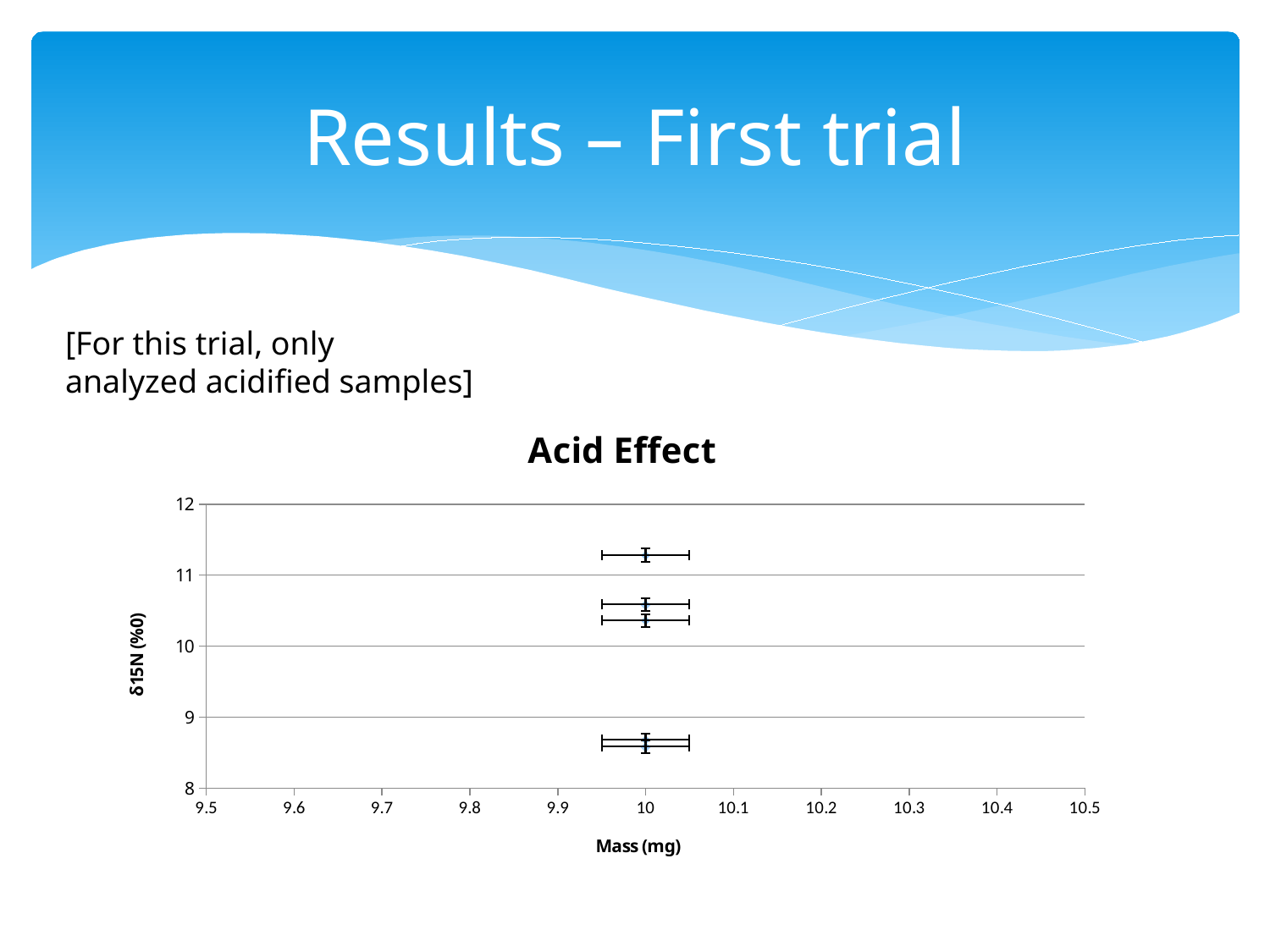
Is the δ15N value of the highest data point greater or less than 12? less What kind of chart is shown on the slide? scatter chart How many data points are plotted on the chart? 5 What is the highest value shown on the y axis? 12 What is the title of the chart? Acid Effect Is the δ15N value of the lowest data point greater or less than 9? less What is the label of the x axis? Mass (mg) How many data points have a δ15N value between 10 and 11? 2 Is the δ15N value of the highest data point greater or less than 11? greater At what mass (mg) are all the data points plotted? 10